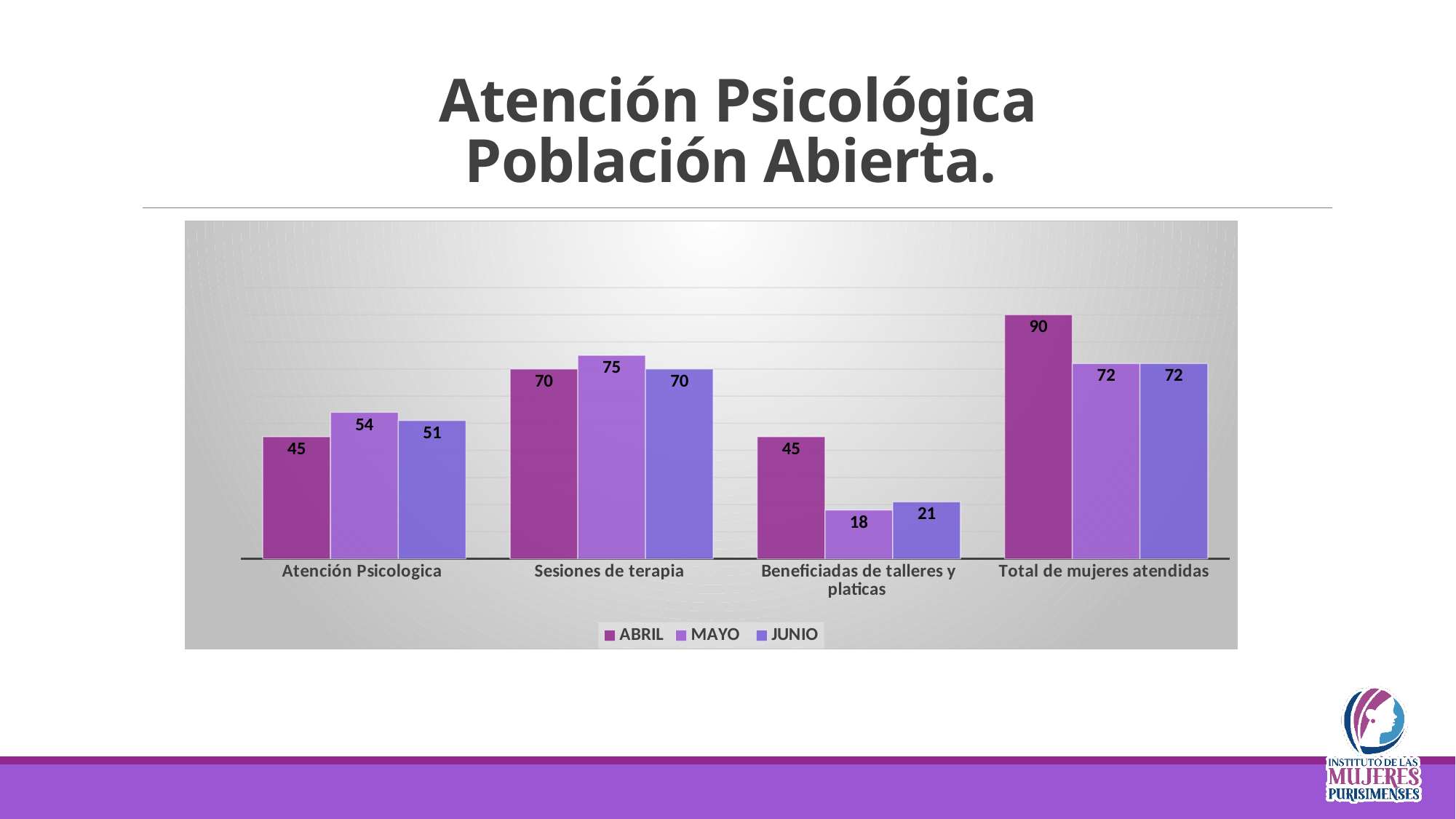
What is the ABRIL value for Total de mujeres atendidas? 90 What is the JUNIO value for Beneficiadas de talleres y platicas? 21 What are the three series listed in the legend? ABRIL, MAYO, JUNIO What is the MAYO value for Sesiones de terapia? 75 Which is larger for Atención Psicologica: the MAYO value or the JUNIO value? MAYO What kind of chart is shown on the slide? Bar chart Which category has the lowest MAYO value? Beneficiadas de talleres y platicas What is the ABRIL value for Atención Psicologica? 45 How many series does the legend list? 3 What is the difference between the ABRIL and MAYO values for Beneficiadas de talleres y platicas? 27 Which category has the highest ABRIL value? Total de mujeres atendidas How many categories are shown on the x axis? 4